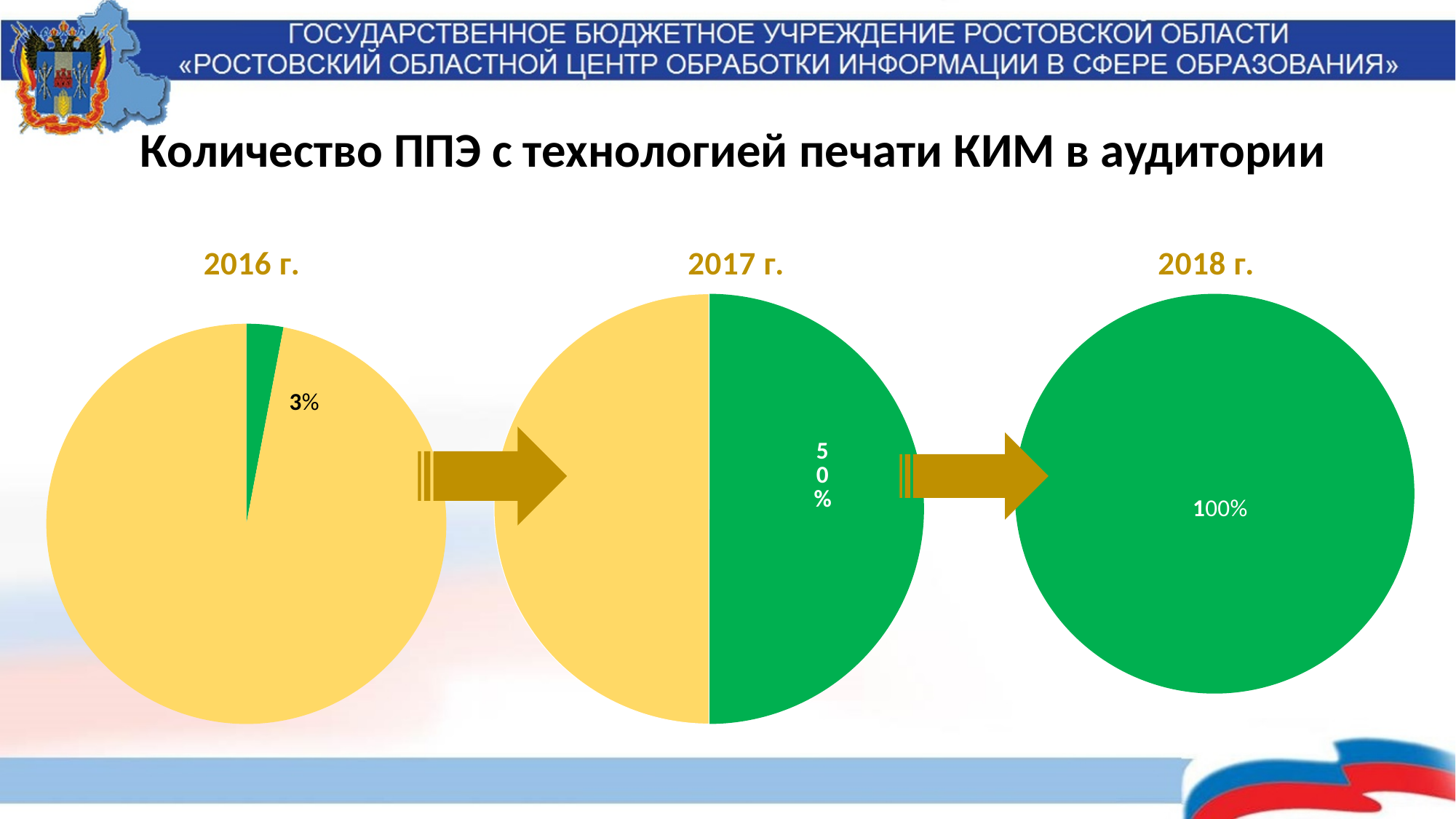
Does the green share rise or fall from the 2016 г. chart to the 2018 г. chart? Rises Which year's pie chart has the largest green share? 2018 г. What is the difference between the green share in the 2018 г. chart and the green share in the 2017 г. chart? 50% What is the title of the slide above the pie charts? Количество ППЭ с технологией печати КИМ в аудитории How many pie charts are on the slide? 3 In the 2018 г. pie chart, what percentage is labelled on the green area? 100% In the 2016 г. pie chart, what percentage does the green slice show? 3% Which year's pie chart has the smallest green share? 2016 г. Which is larger: the green share in the 2017 г. chart or the green share in the 2016 г. chart? 2017 г. What kind of charts are shown on the slide? Pie charts What is the difference between the green share in the 2017 г. chart and the green share in the 2016 г. chart? 47% In the 2017 г. pie chart, what percentage does the green slice show? 50%